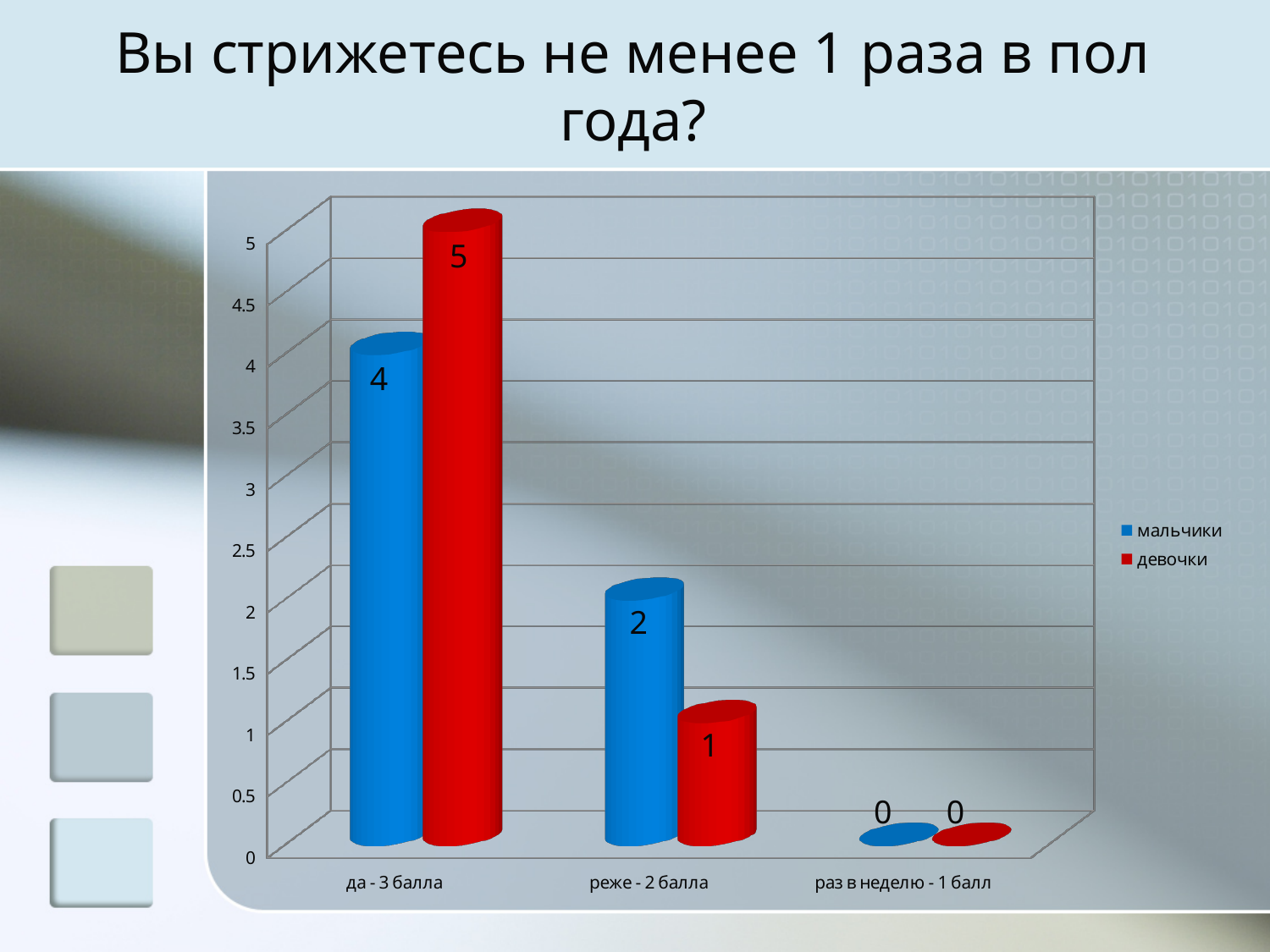
What is the value for мальчики in the category 'да - 3 балла'? 4 Which category has the lowest value for мальчики? раз в неделю - 1 балл How many series does the legend list? 2 Which category has the highest value for девочки? да - 3 балла How many categories are shown on the x axis? 3 What is the value for мальчики in the category 'реже - 2 балла'? 2 In the category 'реже - 2 балла', which series has the larger value, мальчики or девочки? мальчики What is the value for девочки in the category 'реже - 2 балла'? 1 What is the difference between the девочки and мальчики values in the category 'да - 3 балла'? 1 What kind of chart is shown on the slide? bar chart What is the value for девочки in the category 'да - 3 балла'? 5 What is the value for девочки in the category 'раз в неделю - 1 балл'? 0